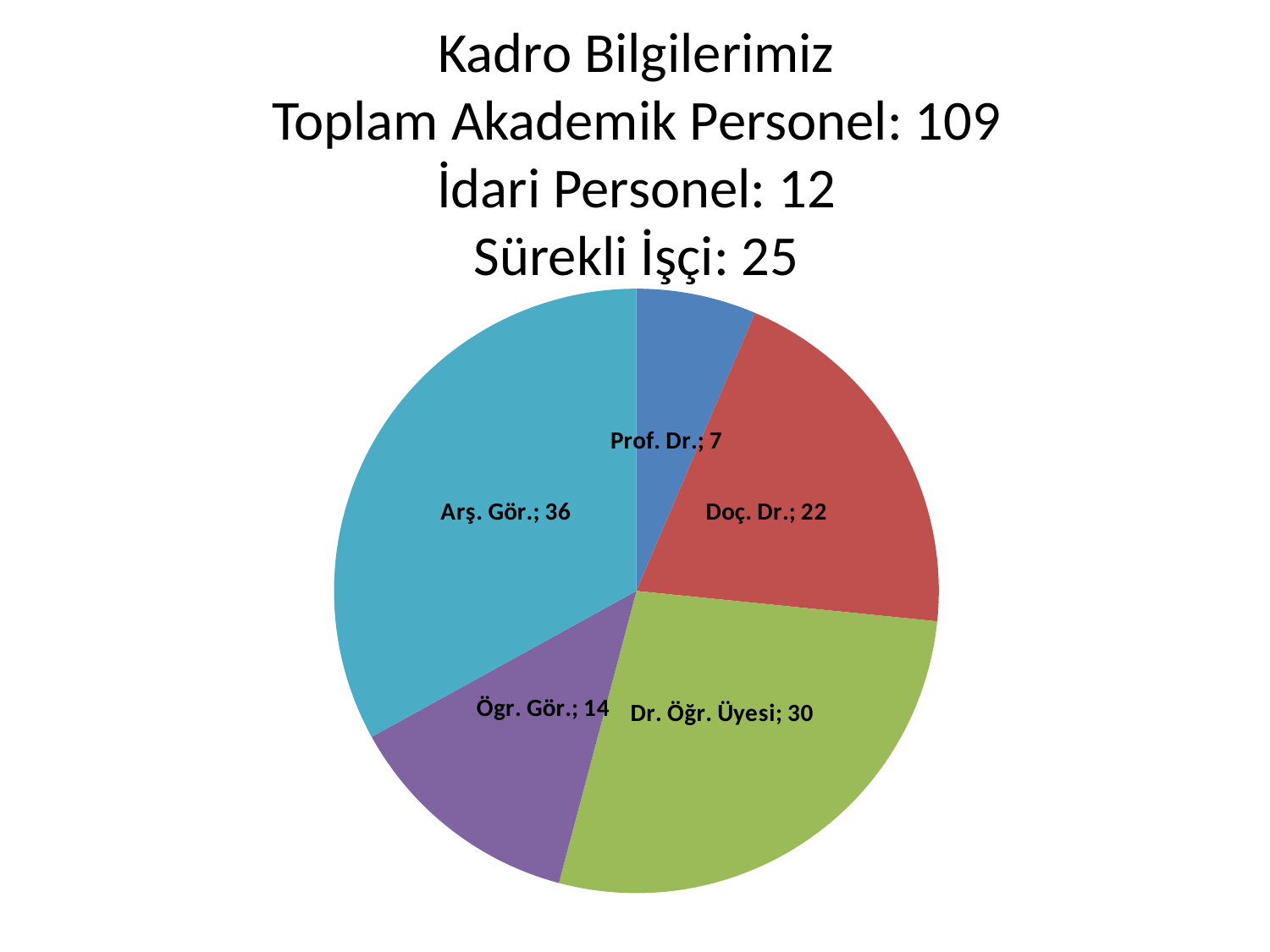
What is the total of all the slices in the pie chart? 109 What is the value for Arş. Gör. in the pie chart? 36 How many slices does the pie chart have? 5 Which is larger, the value for Doç. Dr. or the value for Ögr. Gör.? Doç. Dr. What is the difference between the values for Arş. Gör. and Dr. Öğr. Üyesi? 6 What is the value for Prof. Dr. in the pie chart? 7 What is the value for Doç. Dr. in the pie chart? 22 Which category has the largest slice in the pie chart? Arş. Gör. What is the value for Ögr. Gör. in the pie chart? 14 Which category has the smallest slice in the pie chart? Prof. Dr. What kind of chart is shown on the slide? pie chart What is the value for Dr. Öğr. Üyesi in the pie chart? 30